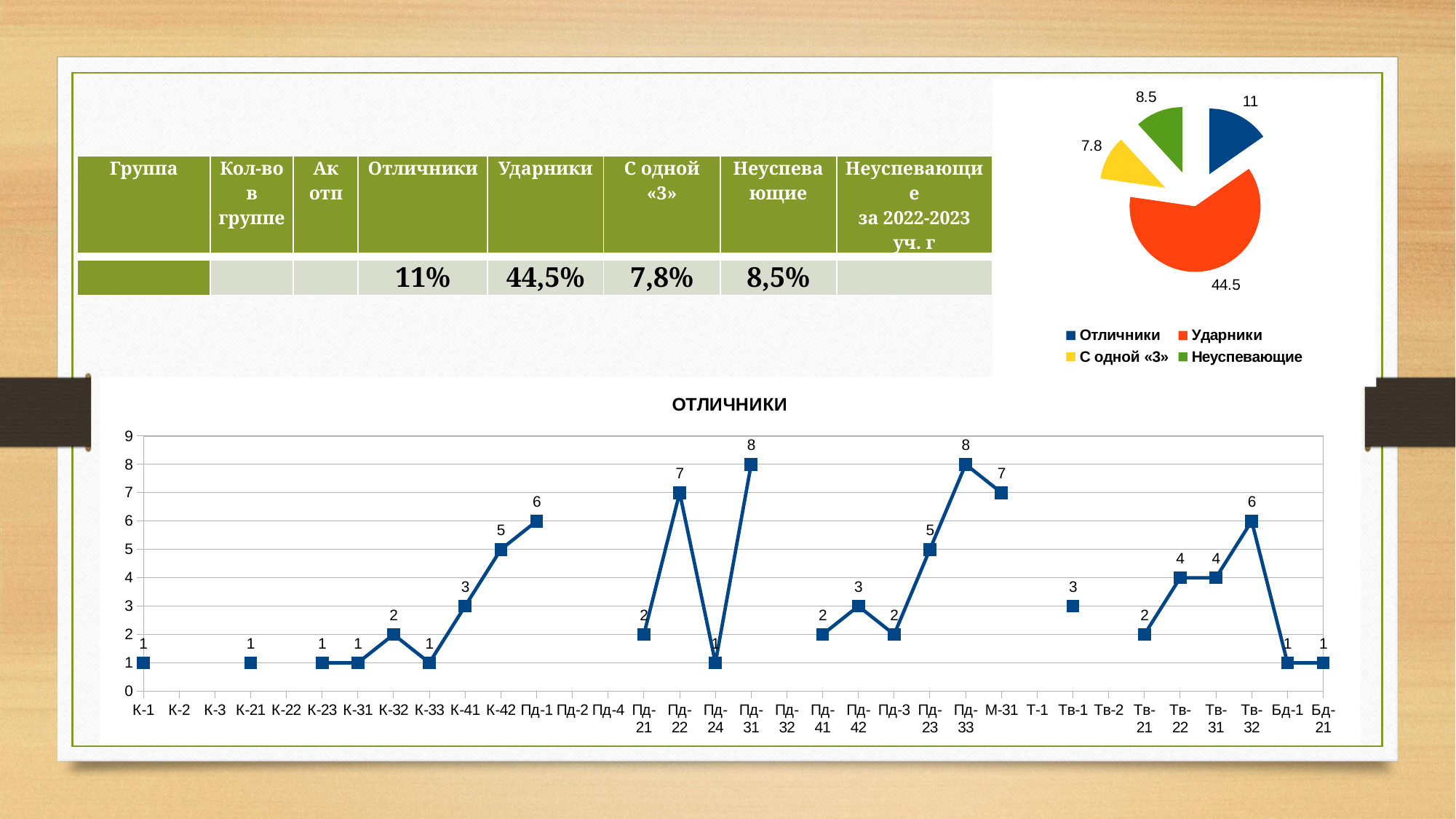
In the pie chart, what value is shown for Ударники? 44.5 In the pie chart, which category has the smallest slice? С одной «3» In the ОТЛИЧНИКИ chart, which is larger, the value for К-42 or the value for Пд-42? К-42 In the ОТЛИЧНИКИ chart, what is the highest value plotted? 8 In the pie chart, which category has the largest slice? Ударники How many categories does the pie chart's legend list? 4 What kind of chart is the chart titled ОТЛИЧНИКИ? Line chart In the pie chart, what is the difference between the values for Ударники and Отличники? 33.5 In the pie chart, which colour represents Неуспевающие? Green How many categories are listed on the x axis of the ОТЛИЧНИКИ chart? 34 In the ОТЛИЧНИКИ chart, what is the value for Тв-32? 6 In the ОТЛИЧНИКИ chart, what is the value for Пд-22? 7